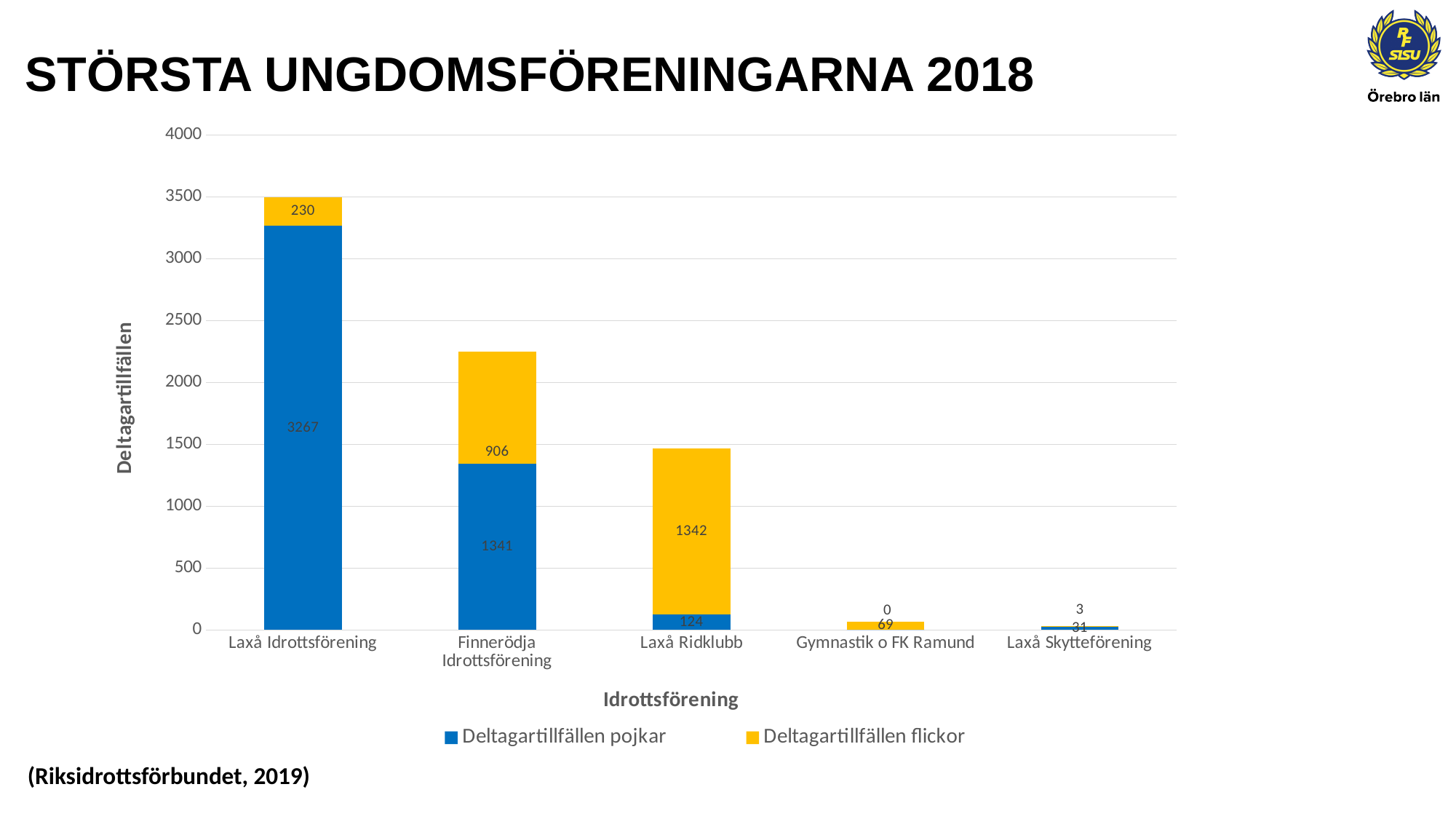
Which category has the lowest value for Deltagartillfällen flickor? Laxå Skytteförening How many categories are shown on the x axis? 5 What is the value of Deltagartillfällen flickor for Laxå Ridklubb? 1342 What is the difference between Deltagartillfällen flickor for Laxå Ridklubb and Finnerödja Idrottsförening? 436 Which category has the highest value for Deltagartillfällen pojkar? Laxå Idrottsförening What kind of chart is shown on the slide? Stacked bar chart How many series does the legend list? 2 What is the value of Deltagartillfällen pojkar for Laxå Skytteförening? 31 Which is larger for Laxå Ridklubb: Deltagartillfällen pojkar or Deltagartillfällen flickor? Deltagartillfällen flickor What is the value of Deltagartillfällen pojkar for Laxå Idrottsförening? 3267 What is the value of Deltagartillfällen flickor for Finnerödja Idrottsförening? 906 What is the total of the stacked bar for Finnerödja Idrottsförening? 2247